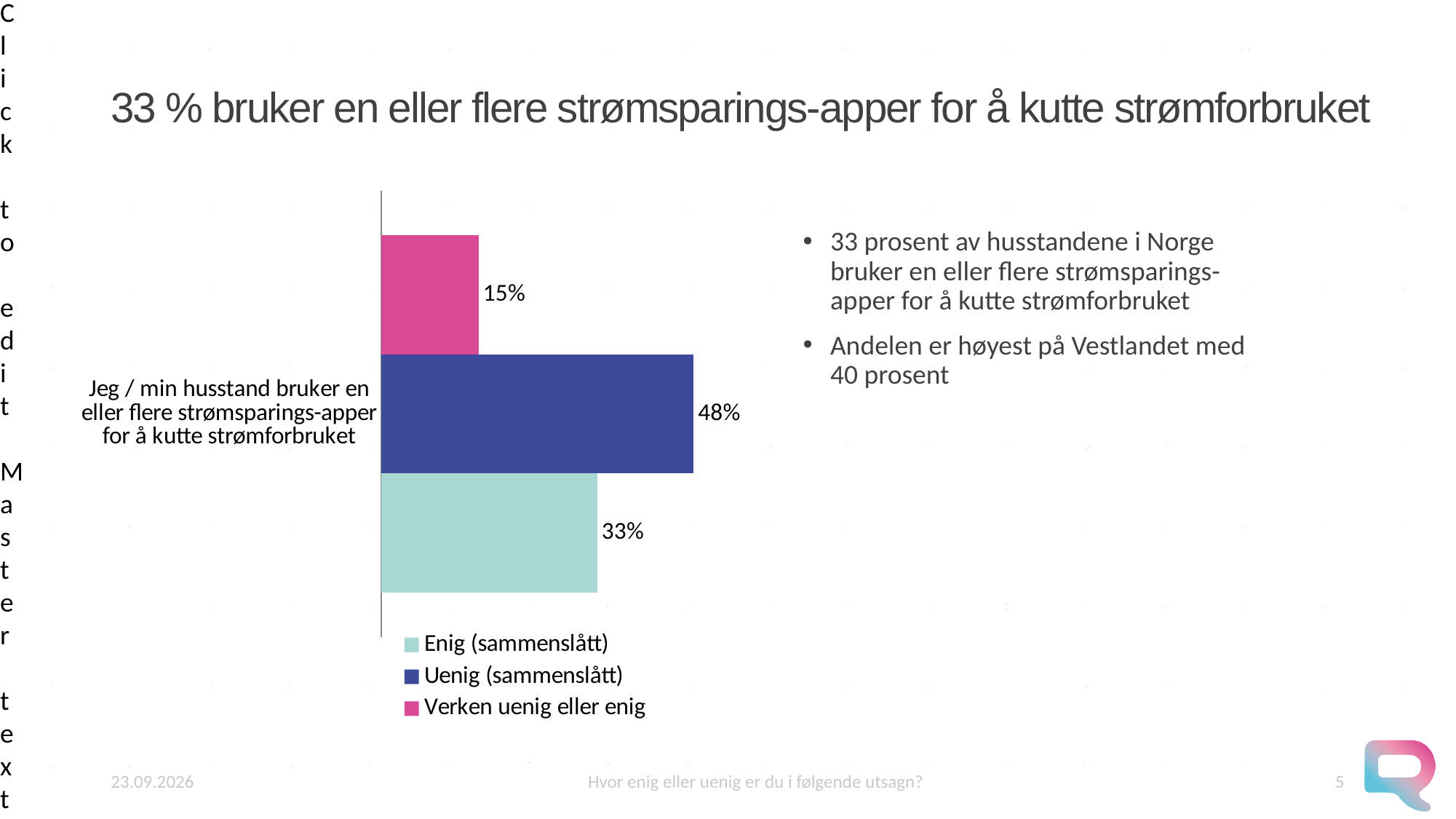
What kind of chart is shown on the slide? Bar chart What is the total of the three values shown in the chart? 96% What is the value for Enig (sammenslått)? 33% What is the difference between Enig (sammenslått) and Verken uenig eller enig? 18% Which series has the lowest value? Verken uenig eller enig Which is larger, Enig (sammenslått) or Verken uenig eller enig? Enig (sammenslått) What is the value for Uenig (sammenslått)? 48% What is the difference between Uenig (sammenslått) and Enig (sammenslått)? 15% Which series has the highest value? Uenig (sammenslått) What is the value for Verken uenig eller enig? 15% How many series does the legend list? 3 What colour is the bar for Uenig (sammenslått)? Dark blue